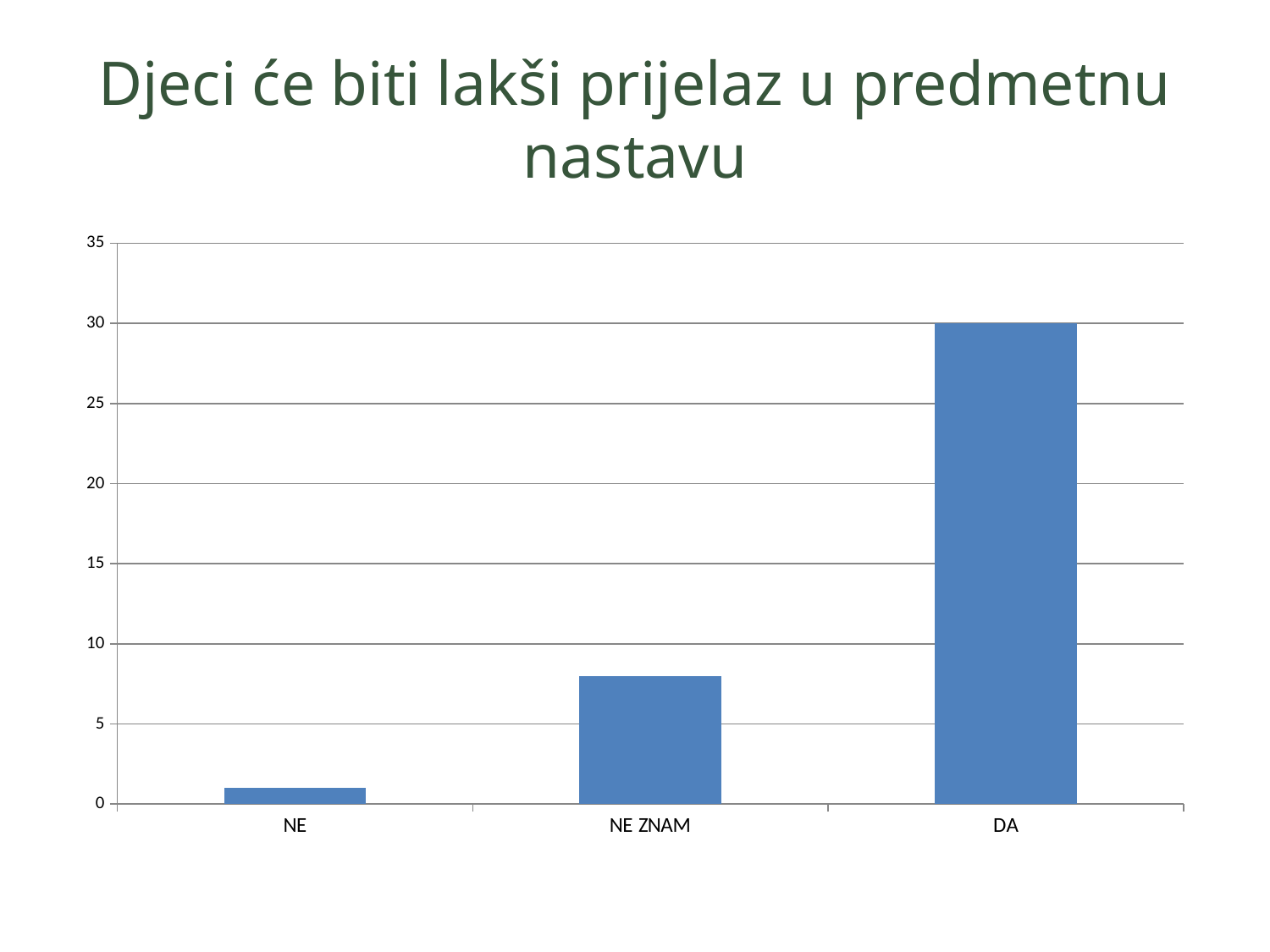
What kind of chart is shown on the slide? bar chart Is the value for NE greater or less than 5? less Do the values rise or fall from left to right along the x axis? rise Which is larger, the value for DA or the value for NE ZNAM? DA Which is larger, the value for NE ZNAM or the value for NE? NE ZNAM Is the value for NE ZNAM greater or less than 5? greater Is the value for NE ZNAM greater or less than 10? less Which category has the lowest value? NE How many categories are shown on the x axis? 3 Which category has the highest value? DA What is the value for DA? 30 What is the title of the slide? Djeci će biti lakši prijelaz u predmetnu nastavu